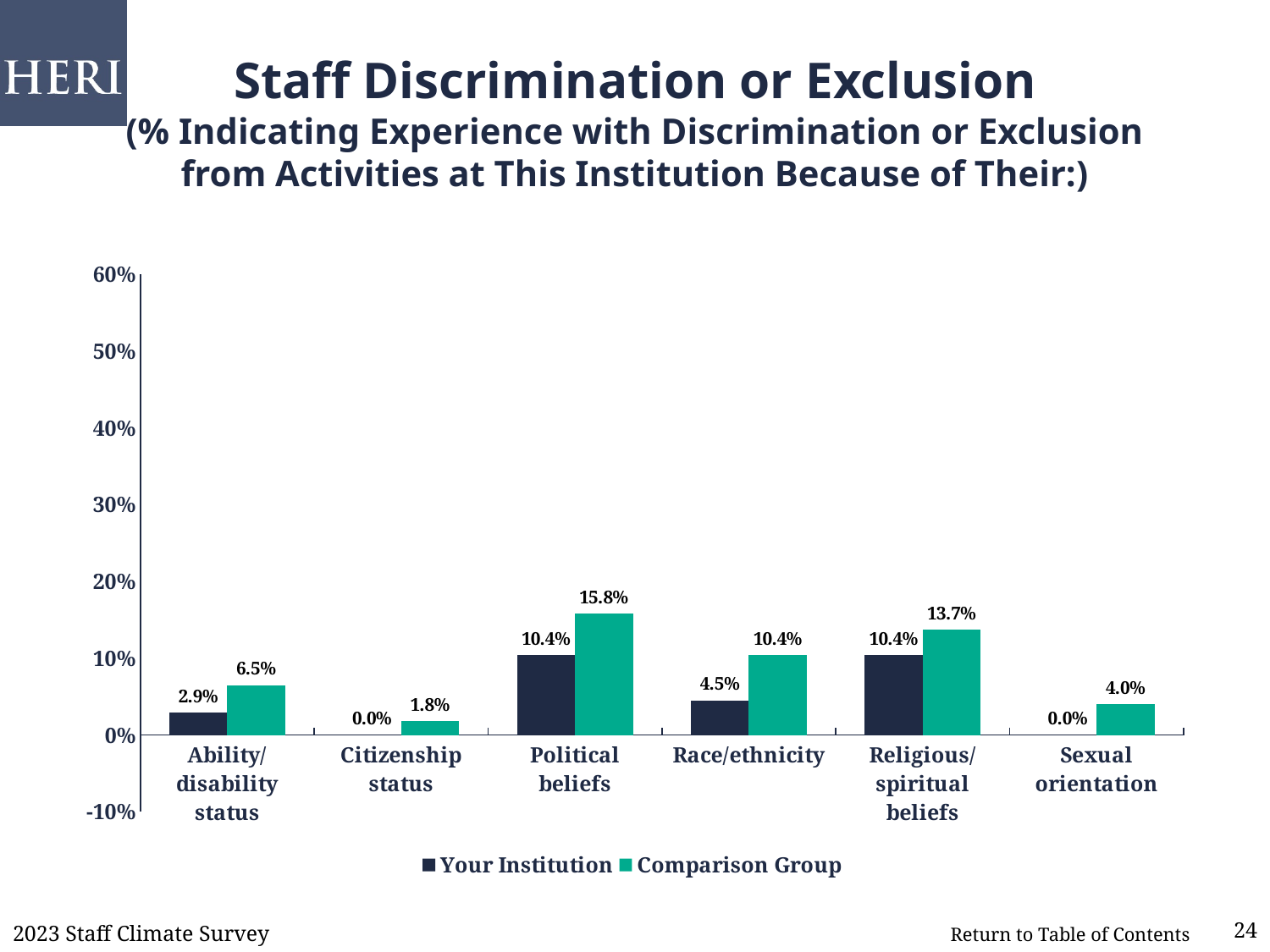
Which is larger: the Comparison Group value for Sexual orientation or the Comparison Group value for Ability/disability status? Ability/disability status What is the difference between the Comparison Group and Your Institution values for Religious/spiritual beliefs? 3.3% How many categories are shown on the x axis? 6 What kind of chart is shown on the slide? Bar chart Which category has the lowest Comparison Group value? Citizenship status What is the Your Institution value for Race/ethnicity? 4.5% What is the difference between the Comparison Group and Your Institution values for Political beliefs? 5.4% What is the Comparison Group value for Political beliefs? 15.8% How many series does the legend list? 2 Which category has the highest Comparison Group value? Political beliefs Which series is shown in green in the legend? Comparison Group What is the Your Institution value for Ability/disability status? 2.9%